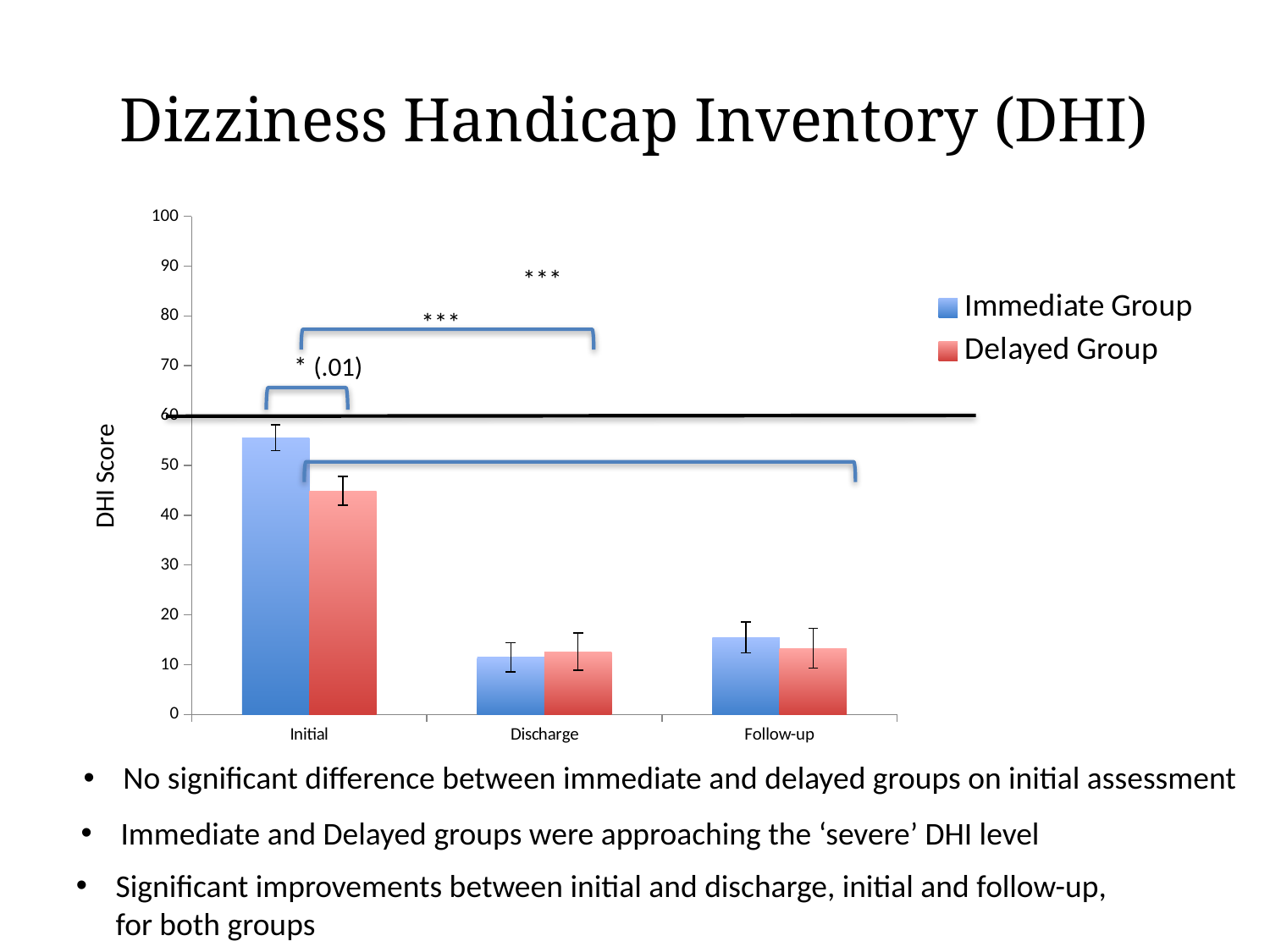
What are the two series named in the legend? Immediate Group and Delayed Group Which category has the highest bar for the Immediate Group? Initial How many categories are shown on the x axis? 3 What is the label on the y axis of the chart? DHI Score Is the Delayed Group's Follow-up DHI score greater or less than 20? less How many series does the legend list? 2 Which category has the highest bar for the Delayed Group? Initial At the Initial assessment, which group has the larger DHI score, Immediate Group or Delayed Group? Immediate Group Is the Immediate Group's Initial DHI score greater or less than 50? greater Is the Delayed Group's Initial DHI score greater or less than 40? greater What kind of chart is shown on the slide? bar chart